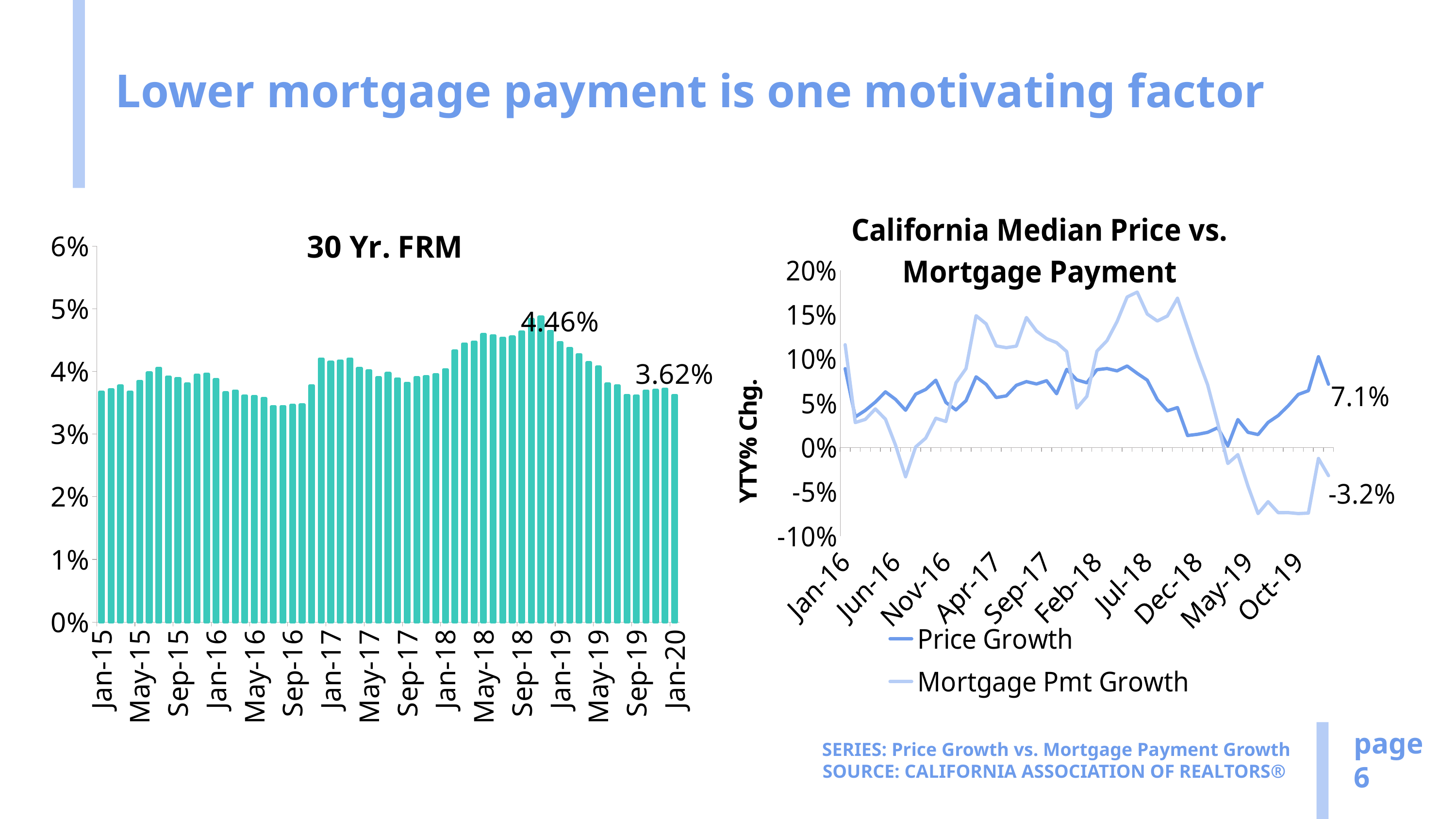
In the "California Median Price vs. Mortgage Payment" chart, what is the final labeled value for Price Growth? 7.1% How many series does the legend of the "California Median Price vs. Mortgage Payment" chart list? 2 In the "30 Yr. FRM" chart, do the values rise or fall from the labeled 4.46% peak to Jan-20? fall In the "30 Yr. FRM" chart, what is the highest labeled value? 4.46% In the "California Median Price vs. Mortgage Payment" chart, what is the final labeled value for Mortgage Pmt Growth? -3.2% What kind of chart is the "California Median Price vs. Mortgage Payment" chart? line chart In the "California Median Price vs. Mortgage Payment" chart, which series has the larger final labeled value, Price Growth or Mortgage Pmt Growth? Price Growth What kind of chart is the "30 Yr. FRM" chart? bar chart In the "30 Yr. FRM" chart, what is the difference between the labeled peak value and the Jan-20 value? 0.84 percentage points In the "30 Yr. FRM" chart, what is the value for Jan-20? 3.62% In the "30 Yr. FRM" chart, is the value for Jan-15 greater or less than 4%? less What is the y-axis label of the "California Median Price vs. Mortgage Payment" chart? YTY% Chg.